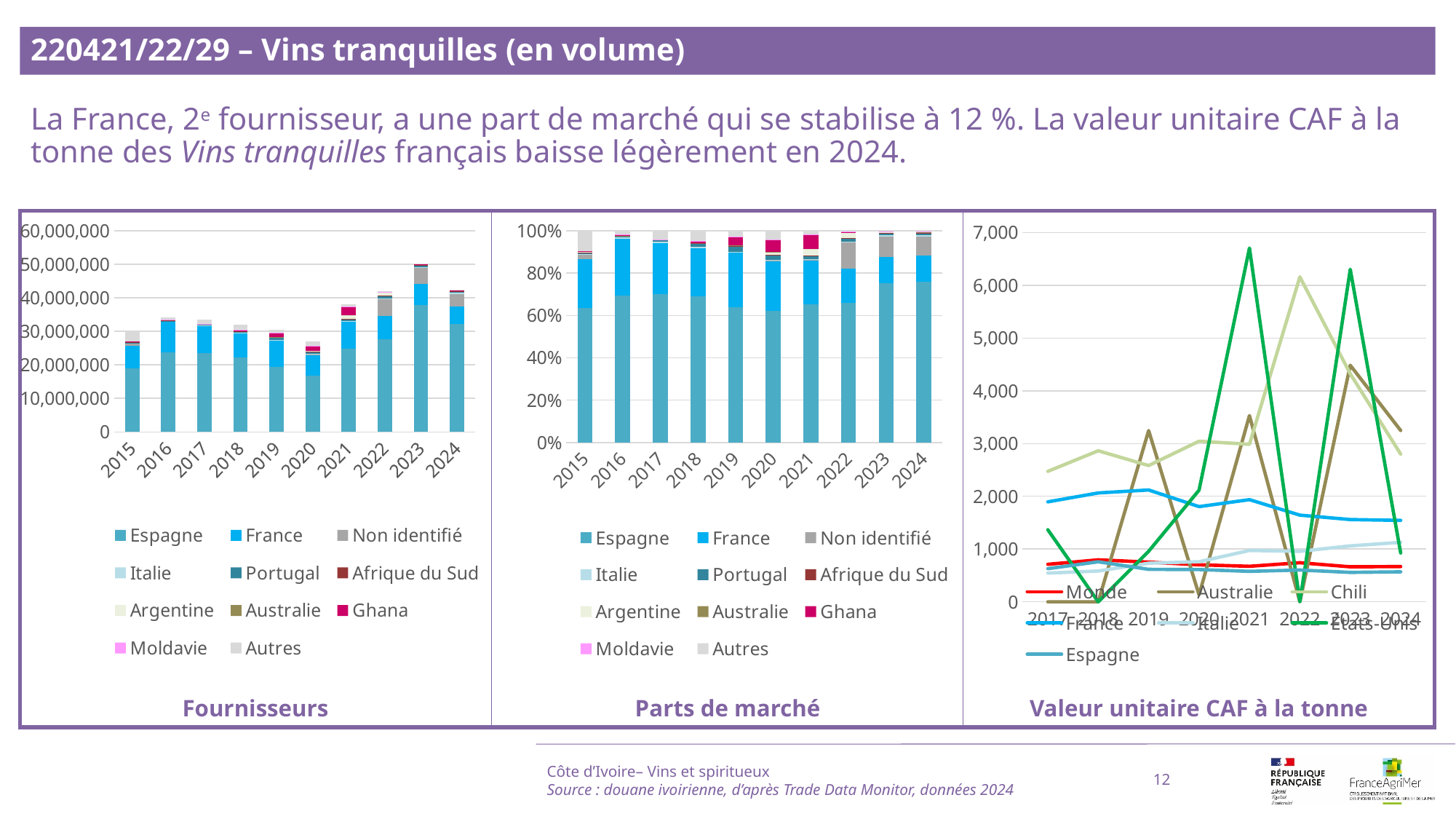
In the 'Valeur unitaire CAF à la tonne' chart, is the value for États-Unis in 2022 greater or less than 6,000? less In the 'Valeur unitaire CAF à la tonne' chart, which series reaches the highest value on the chart? États-Unis How many series does the legend of the 'Parts de marché' chart list? 11 What kind of chart is the 'Valeur unitaire CAF à la tonne' chart? line chart In the 'Valeur unitaire CAF à la tonne' chart, is the value for France in 2024 greater or less than 1,000? greater In the 'Fournisseurs' chart, is the total for 2023 greater or less than 40,000,000? greater What kind of chart is the 'Fournisseurs' chart? bar chart In the 'Fournisseurs' chart, which year has the highest total bar? 2023 How many series does the legend of the 'Valeur unitaire CAF à la tonne' chart list? 7 How many years are shown on the x axis of the 'Fournisseurs' chart? 10 In the 'Fournisseurs' chart, which year has the lowest total bar? 2020